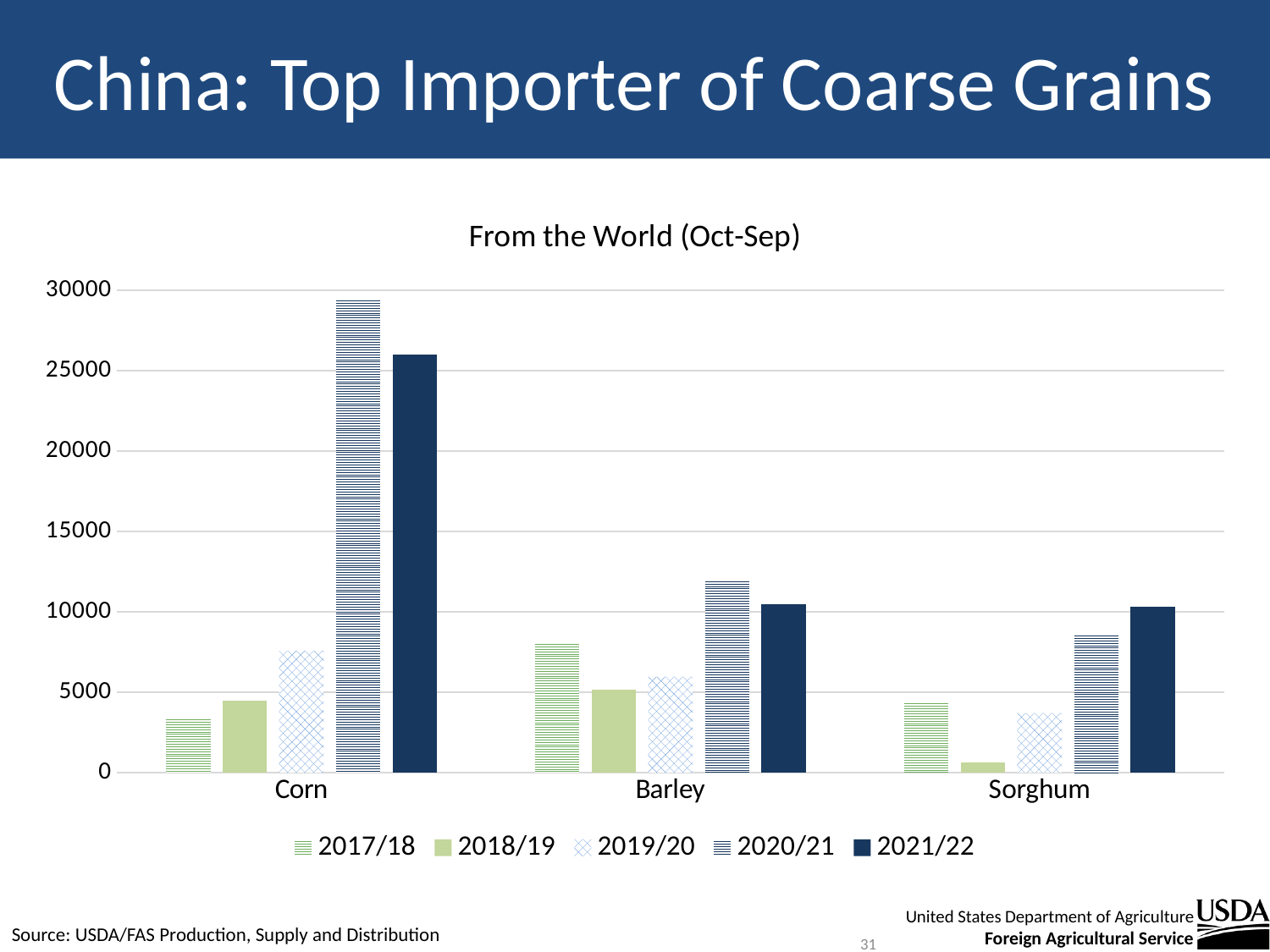
Is the value for Barley in 2020/21 greater or less than 10000? greater For Sorghum, which is larger: the 2020/21 bar or the 2021/22 bar? 2021/22 Which commodity has the highest 2020/21 bar? Corn For Sorghum, which year has the lowest bar? 2018/19 How many series does the legend list? 5 How many commodity categories are shown on the x axis? 3 Is the value for Corn in 2019/20 greater or less than 5000? greater Is the value for Sorghum in 2018/19 greater or less than 5000? less For Corn, which is larger: the 2020/21 bar or the 2021/22 bar? 2020/21 What is the title shown above the chart? From the World (Oct-Sep) What kind of chart is shown on the slide? bar chart